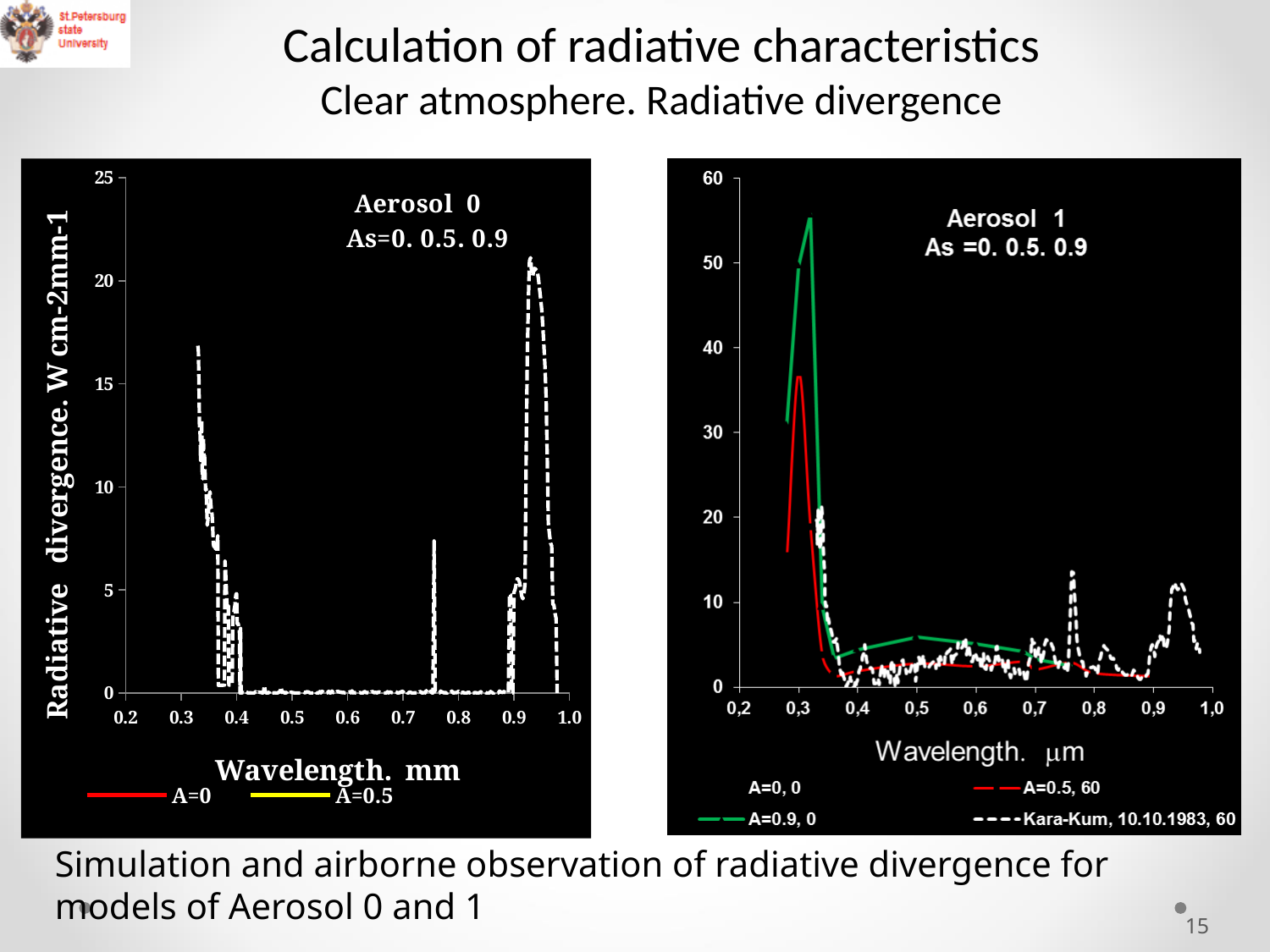
What is the highest value shown on the y-axis of the right chart (Aerosol 1)? 60 In the right chart (Aerosol 1), is the peak value of the red A=0, 0 series greater or less than 40? less How many series does the legend of the right chart (Aerosol 1) list? 4 In the left chart (Aerosol 0), is the peak of the dashed curve near wavelength 0.93 greater or less than 20? greater What kind of chart is the right chart (Aerosol 1)? line chart What is the label of the x-axis of the left chart (Aerosol 0)? Wavelength. mm In the left chart (Aerosol 0), is the peak of the dashed curve near wavelength 0.33 greater or less than 15? greater How many series does the legend of the left chart (Aerosol 0) list? 2 In the right chart (Aerosol 1), what is the name of the dashed white series in the legend? Kara-Kum, 10.10.1983, 60 In the right chart (Aerosol 1), which series reaches a higher peak, the green A=0.9, 0 series or the red A=0, 0 series? A=0.9, 0 What kind of chart is the left chart (Aerosol 0)? line chart